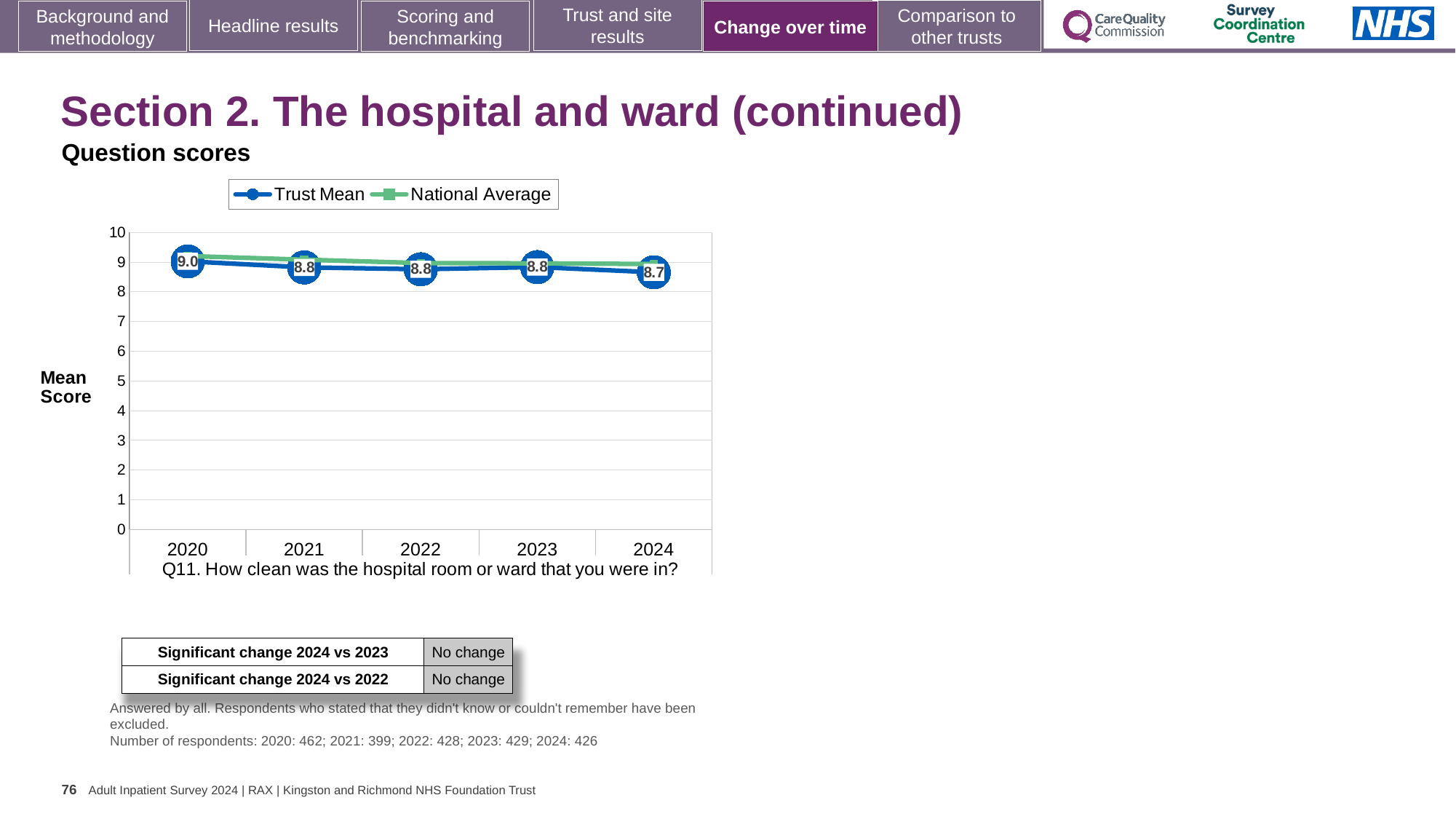
What is the Trust Mean score for 2020? 9.0 How many years are plotted on the x axis? 5 What kind of chart is shown on the slide? line chart In which year is the Trust Mean lowest? 2024 Which question does the chart show scores for? Q11. How clean was the hospital room or ward that you were in? Is the National Average for 2024 greater or less than 8? greater What is the Trust Mean score for 2024? 8.7 How many series does the legend list? 2 In which year is the Trust Mean highest? 2020 Does the Trust Mean rise or fall from 2020 to 2024? fall What is the difference between the Trust Mean in 2020 and in 2024? 0.3 What is the Trust Mean score for 2022? 8.8